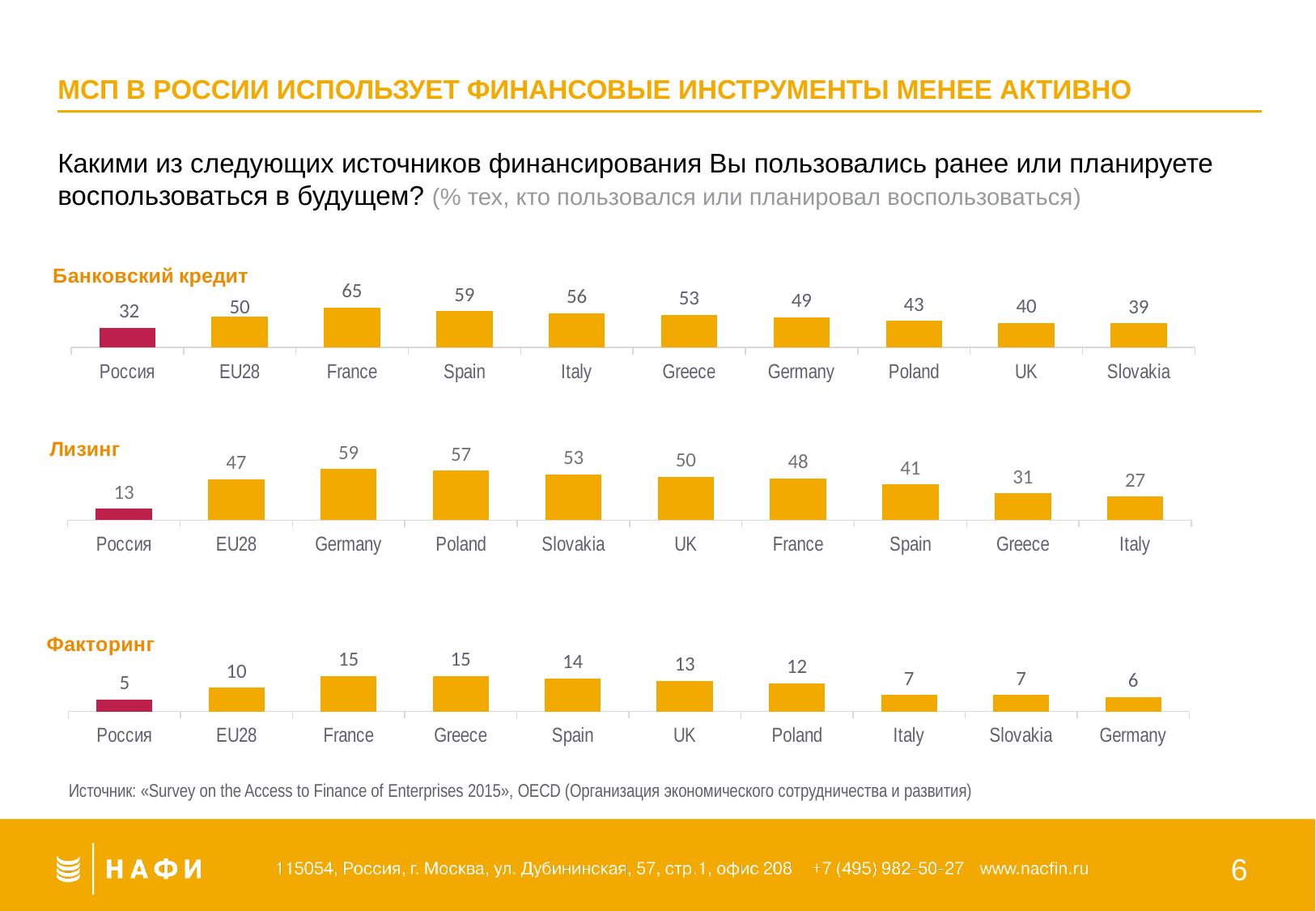
In the 'Банковский кредит' chart, what is the value for France? 65 Which category's bar is coloured differently (red) from the others in each of the three charts? Россия What type of chart is the 'Лизинг' chart? Bar chart In the 'Лизинг' chart, what is the value for Россия? 13 In the 'Лизинг' chart, which category has the highest value? Germany In the 'Банковский кредит' chart, do the values rise or fall from France to Slovakia along the x axis? Fall In the 'Банковский кредит' chart, which category has the lowest value? Россия In the 'Лизинг' chart, which is larger, the value for Greece or the value for Italy? Greece In the 'Факторинг' chart, what is the difference between the values for France and Germany? 9 In the 'Банковский кредит' chart, what is the difference between the values for EU28 and Россия? 18 How many categories are shown in the 'Факторинг' chart? 10 In the 'Факторинг' chart, what is the value for EU28? 10